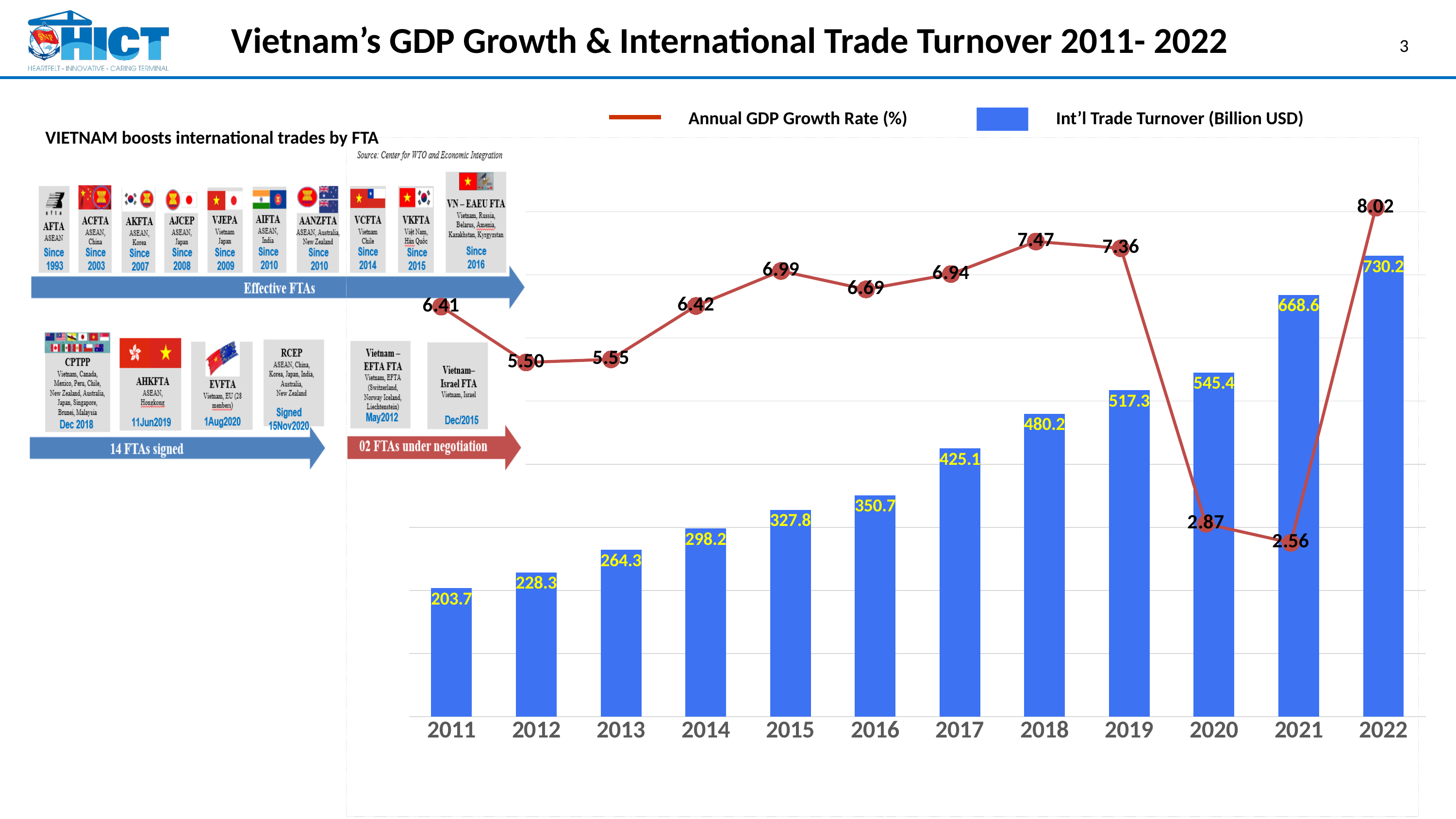
What was Vietnam's Int'l Trade Turnover (Billion USD) in 2022? 730.2 How many years are shown on the x axis of the chart? 12 How many series does the chart legend list? 2 What is the difference in Int'l Trade Turnover (Billion USD) between 2022 and 2021? 61.6 What was the Annual GDP Growth Rate (%) in 2018? 7.47 Was the Annual GDP Growth Rate (%) higher in 2015 or in 2016? 2015 What was the Int'l Trade Turnover (Billion USD) in 2011? 203.7 Which year had the highest Annual GDP Growth Rate (%)? 2022 Does the Int'l Trade Turnover (Billion USD) rise or fall from 2011 to 2022? rise Which year had the lowest Annual GDP Growth Rate (%)? 2021 Which year had the lowest Int'l Trade Turnover (Billion USD)? 2011 What was the Annual GDP Growth Rate (%) in 2020? 2.87